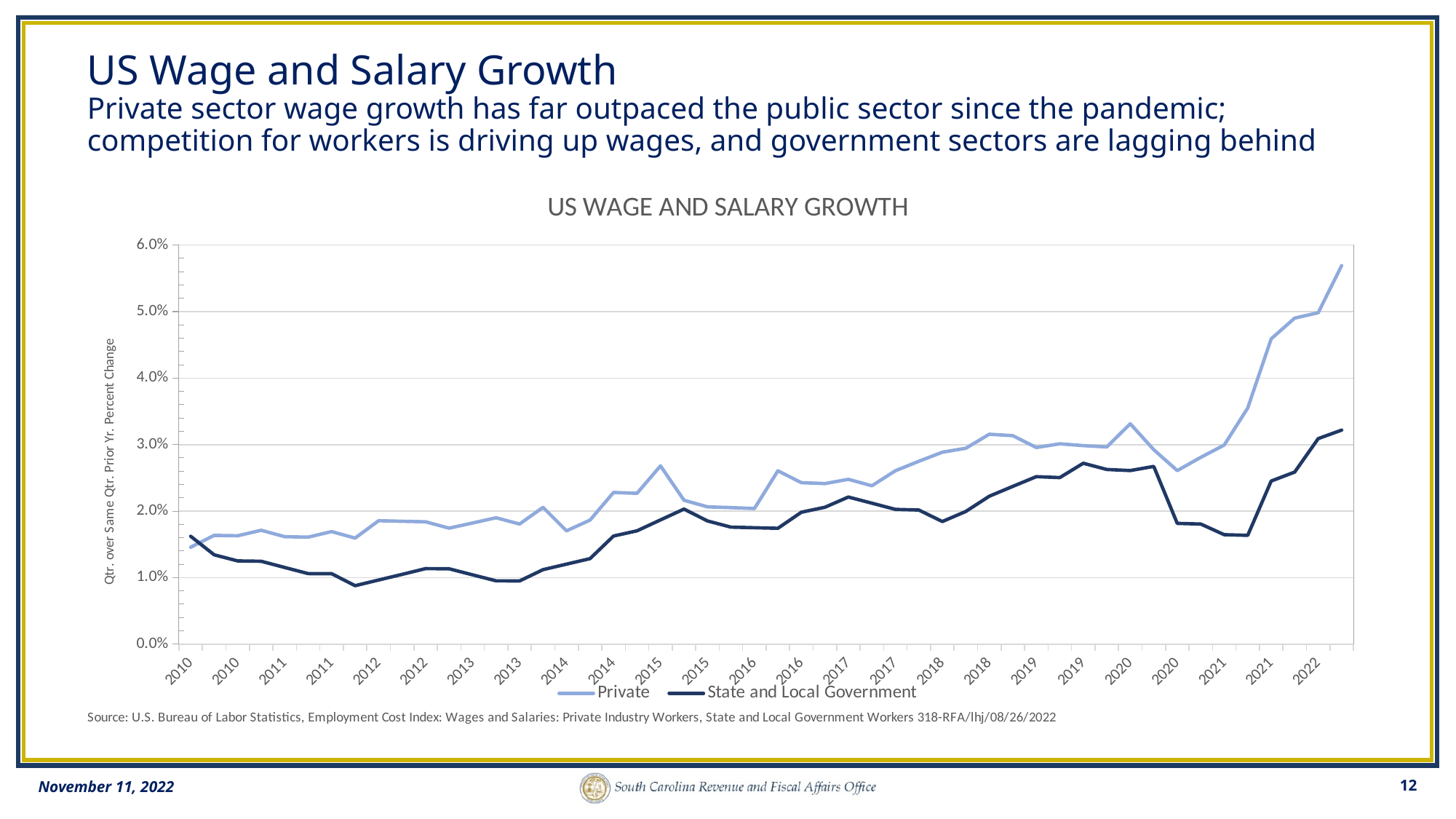
What is the highest value shown on the vertical axis? 6.0% Is the value for State and Local Government at the last point in 2022 greater or less than 2.0%? greater What are the two series named in the chart's legend? Private; State and Local Government Is the value for Private at the last point in 2022 greater or less than 5.0%? greater Which series reaches the highest value anywhere on the chart? Private Which series is higher at the last point in 2022, Private or State and Local Government? Private How many series does the chart's legend list? 2 Is the value for Private at the first point in 2010 greater or less than 2.0%? less What kind of chart is shown on the slide? Line chart Does the Private series rise or fall between 2020 and the end of 2022? Rise What is the title of the chart? US WAGE AND SALARY GROWTH